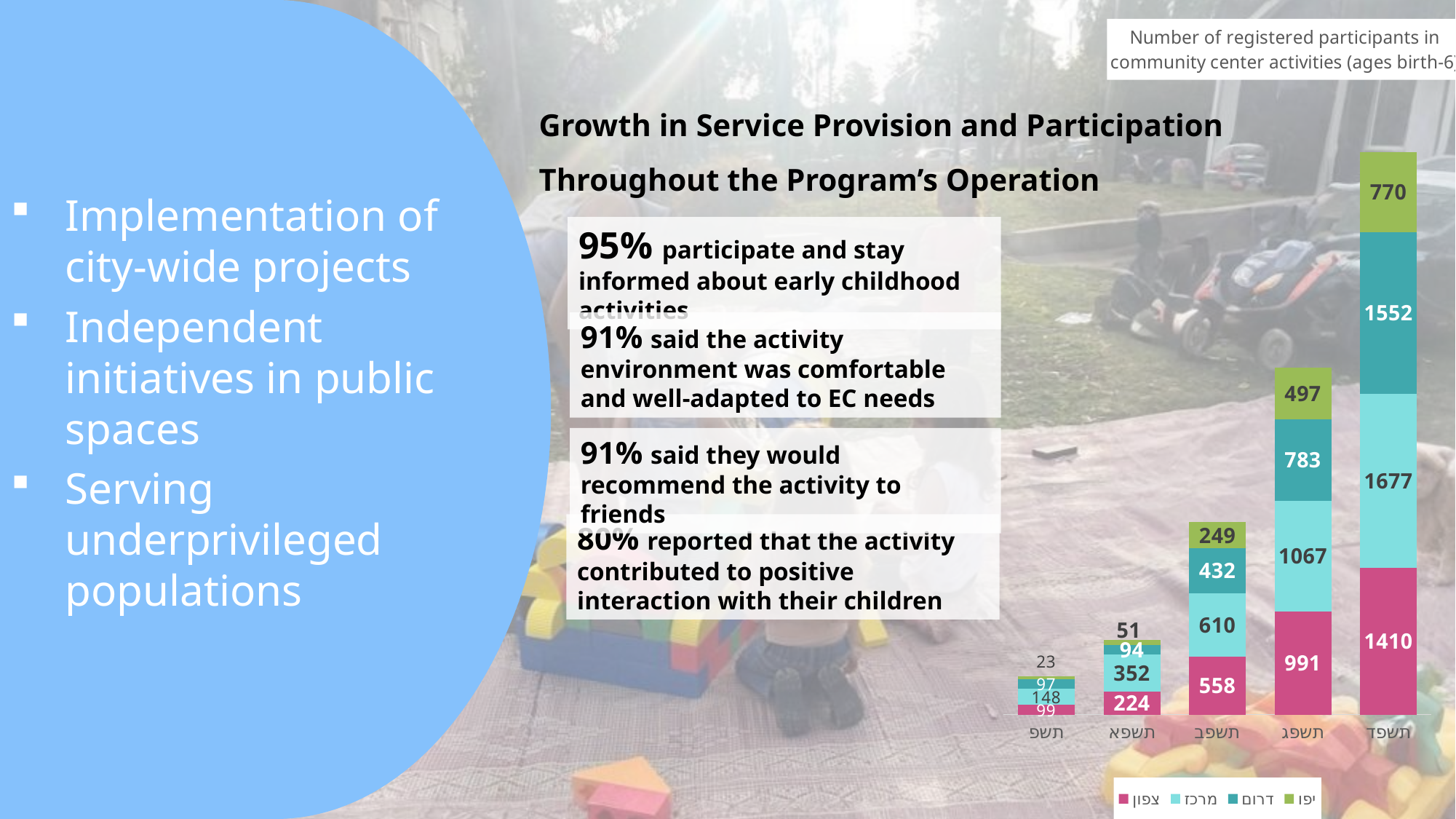
Do the totals rise or fall from תשפ to תשפד? Rise What type of chart is shown on the slide? Stacked bar chart Which year has the highest total number of registered participants? תשפד Which year has the lowest total number of registered participants? תשפ What is the total of the stacked bar for תשפג? 3338 What is the value for מרכז in תשפב? 610 What is the value for צפון in תשפד? 1410 What is the difference between the מרכז values for תשפד and תשפג? 610 What is the value for דרום in תשפא? 94 What is the value for יפו in תשפג? 497 How many categories (years) are shown on the x axis of the chart? 5 How many series does the chart legend list? 4